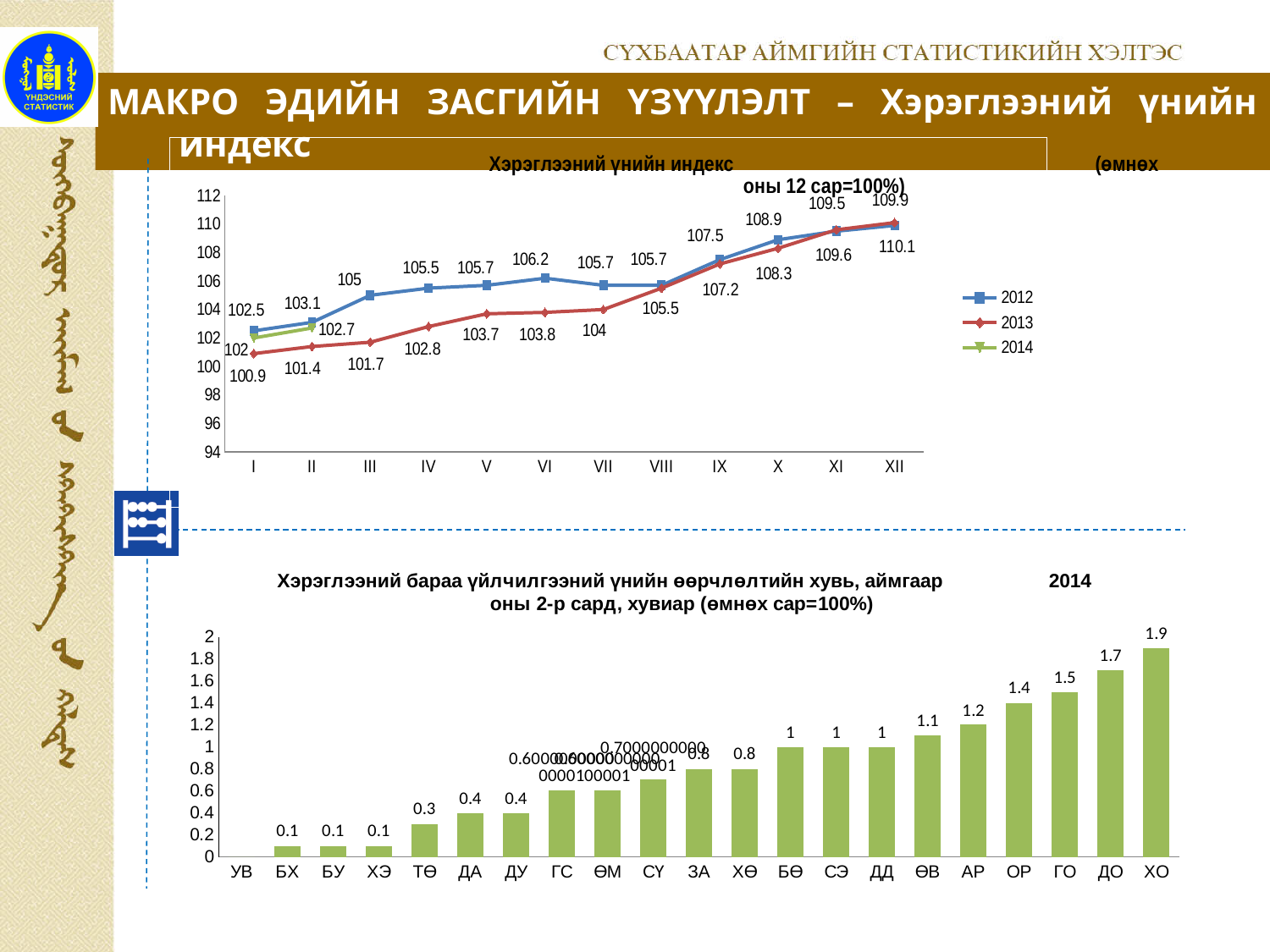
In the top chart, what is the 2014 value for month II? 102.7 In the top chart, in which month does the 2013 series reach its highest value? XII In the top chart, does the 2013 series rise or fall from month I to month XII? rise What kind of chart is the top chart, 'Хэрэглээний үнийн индекс'? line chart In the top chart, what is the 2013 value for month I? 100.9 In the top chart, what is the 2012 value for month VI? 106.2 What kind of chart is the bottom chart? bar chart In the bottom chart, what is the value for АР? 1.2 How many series does the legend of the top chart list? 3 In the top chart, what is the difference between the 2013 and 2012 values in month XII? 0.2 In the bottom chart, which is larger, the value for ДО or the value for ГО? ДО In the bottom chart, which category has the highest value? ХО